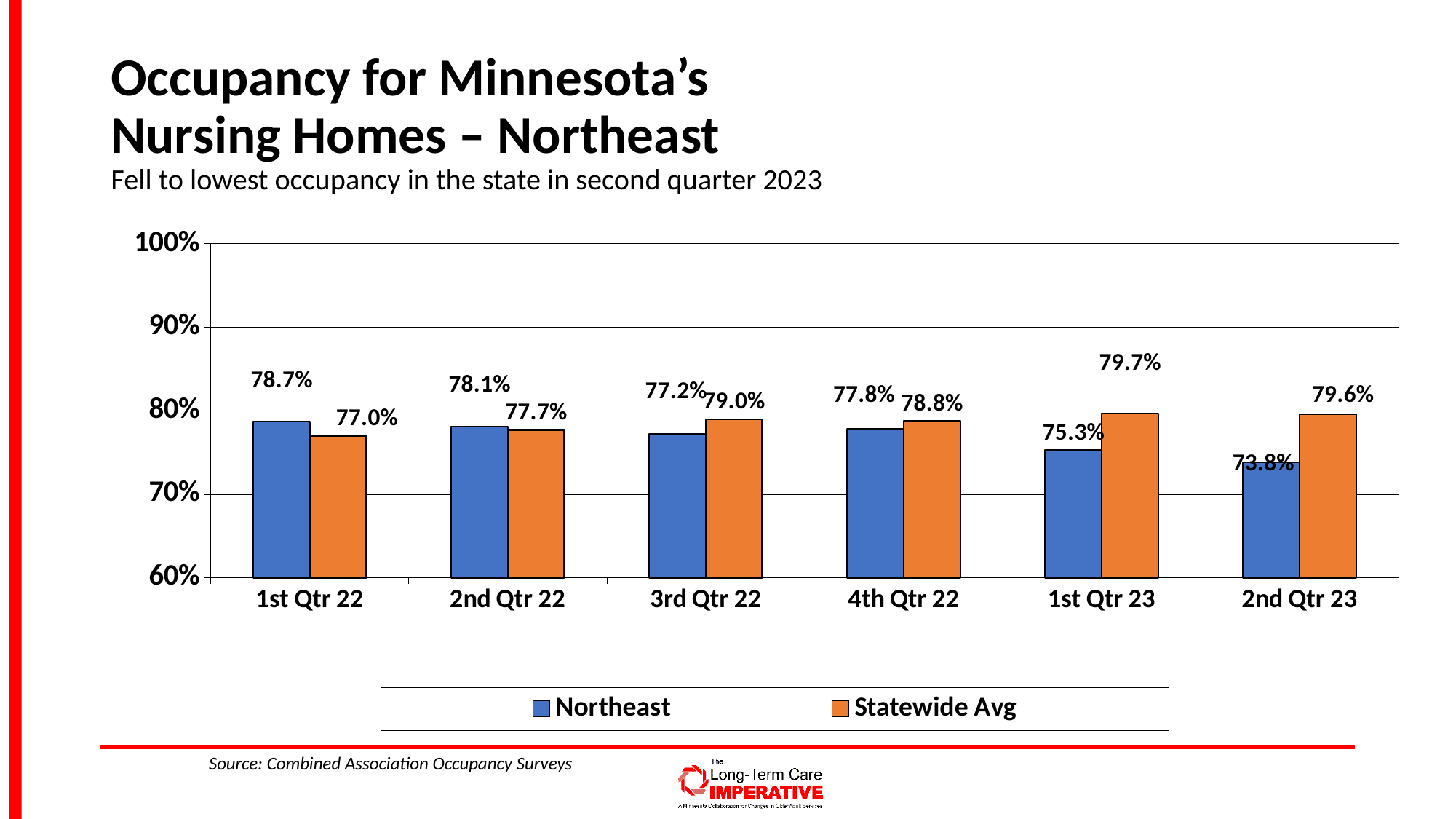
What is the Statewide Avg value for 2nd Qtr 23? 79.6% In which quarter is the Statewide Avg highest? 1st Qtr 23 Is the Northeast value for 1st Qtr 23 greater or less than 80%? less What is the Statewide Avg value for 3rd Qtr 22? 79.0% What kind of chart is shown on the slide? bar chart How many series does the legend list? 2 What is the Northeast occupancy value for 1st Qtr 22? 78.7% Which is larger in 1st Qtr 22, the Northeast value or the Statewide Avg value? Northeast In which quarter is the Northeast occupancy lowest? 2nd Qtr 23 What is the Northeast occupancy value for 2nd Qtr 23? 73.8% How many quarters are shown on the x axis? 6 What is the difference between the Statewide Avg and Northeast values in 2nd Qtr 23? 5.8%